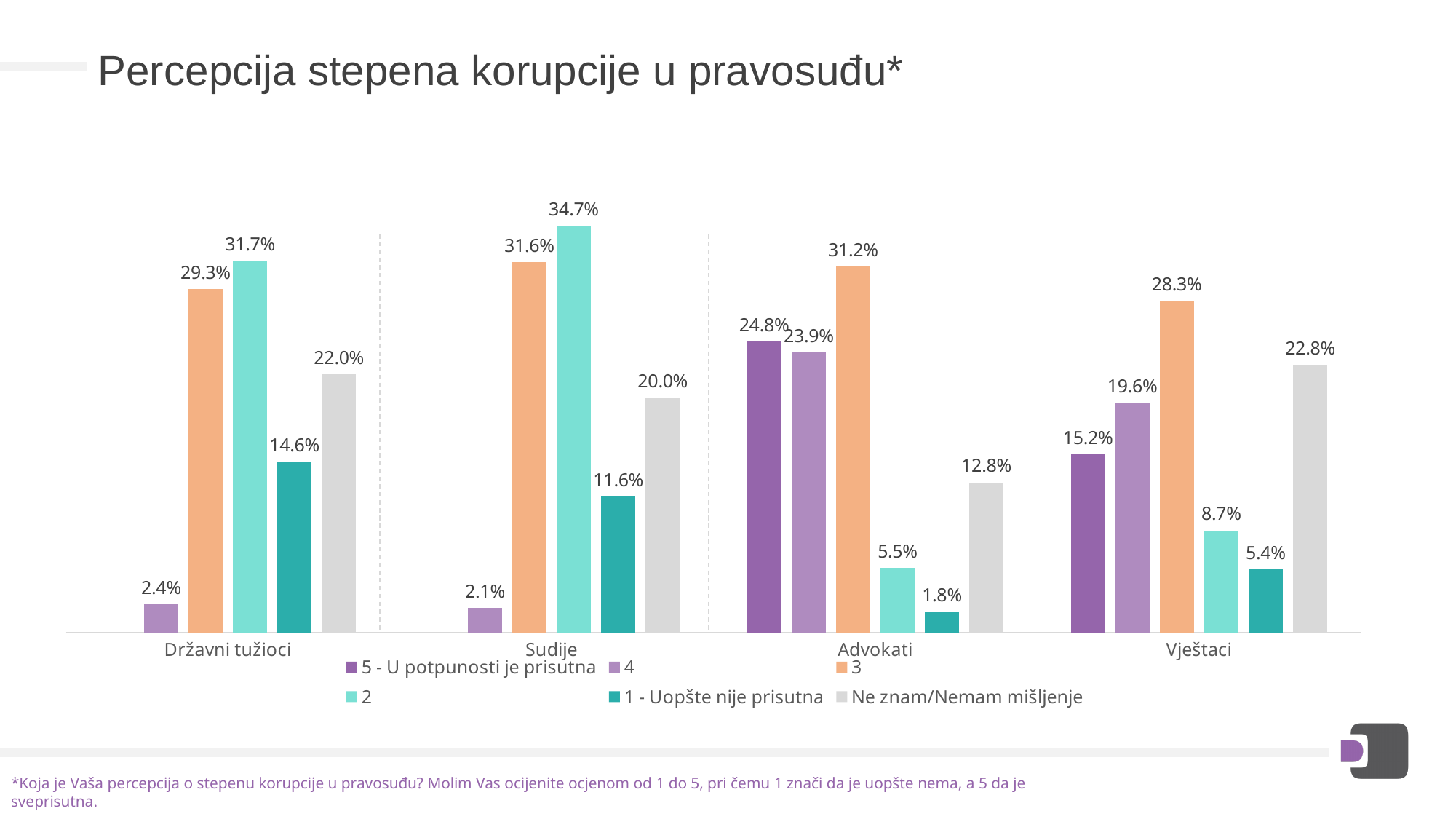
What is the value for 'Ne znam/Nemam mišljenje' for Vještaci? 22.8% What is the value for '3' for Advokati? 31.2% What is the value for '2' for Sudije? 34.7% What kind of chart is shown on the slide? bar chart How many series does the legend list? 6 Which is larger: the '2' value for Državni tužioci or the '2' value for Vještaci? Državni tužioci What is the title of the chart? Percepcija stepena korupcije u pravosuđu* Which category has the highest value for '5 - U potpunosti je prisutna'? Advokati Which category has the lowest value for '4'? Sudije What is the difference between the '3' values for Advokati and Vještaci? 2.9% How many categories are shown on the x axis? 4 What is the value for '1 - Uopšte nije prisutna' for Državni tužioci? 14.6%